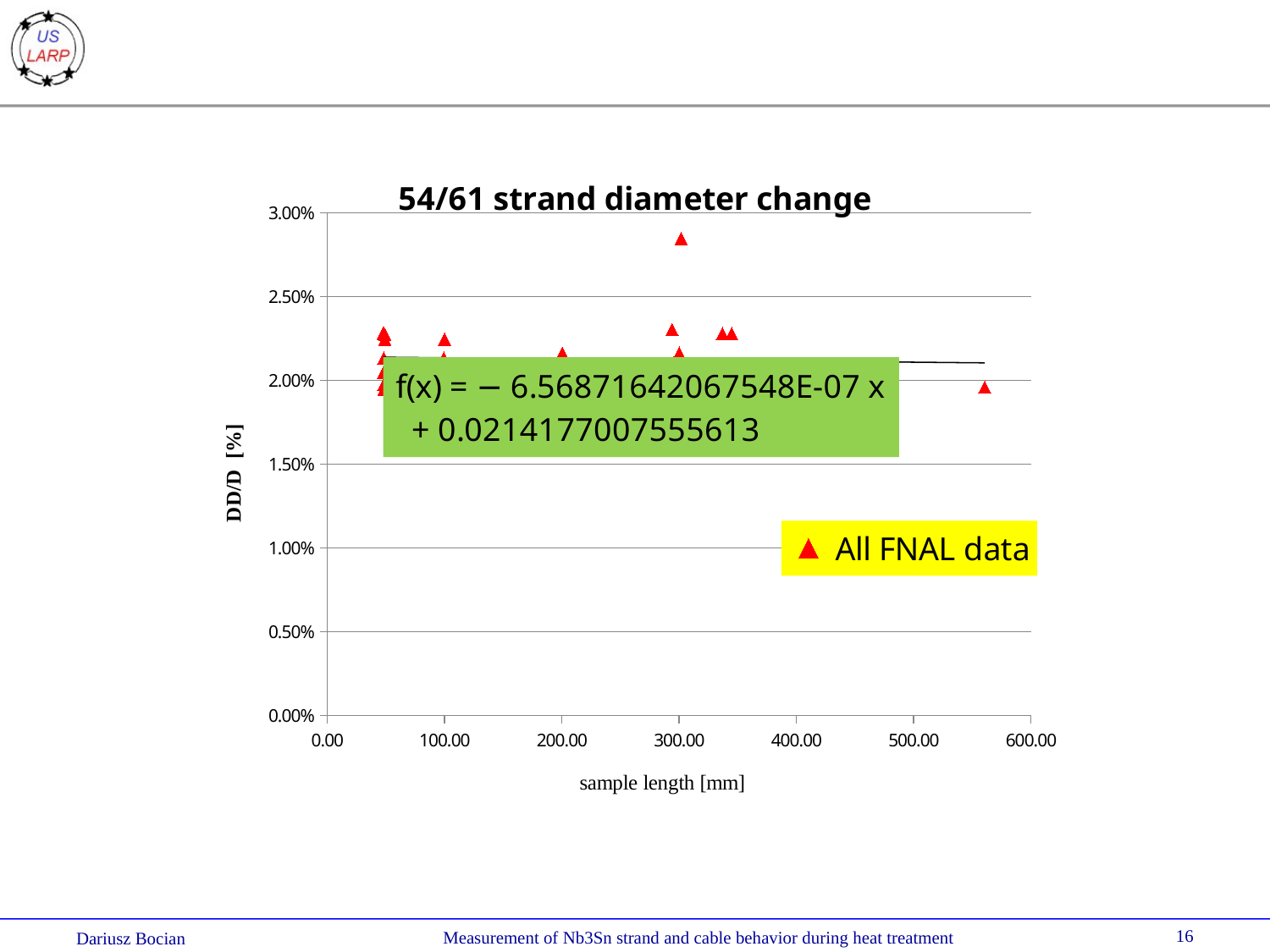
Is the value of the point plotted near a sample length of 200 mm greater or less than 2.50%? less Are the values of the points plotted near a sample length of 340 mm greater or less than 2.00%? greater Does the fitted trendline rise or fall as sample length increases? fall What is the intercept term in the fitted equation f(x) shown on the chart? 0.0214177007555613 What is the title of the chart? 54/61 strand diameter change How many series does the legend list? 1 What is the label of the x axis? sample length [mm] Is the highest plotted value greater or less than 2.50%? greater What is the slope coefficient of x in the fitted equation f(x) shown on the chart? − 6.56871642067548E-07 What is the name of the series shown in the legend? All FNAL data What kind of chart is shown on the slide? scatter chart